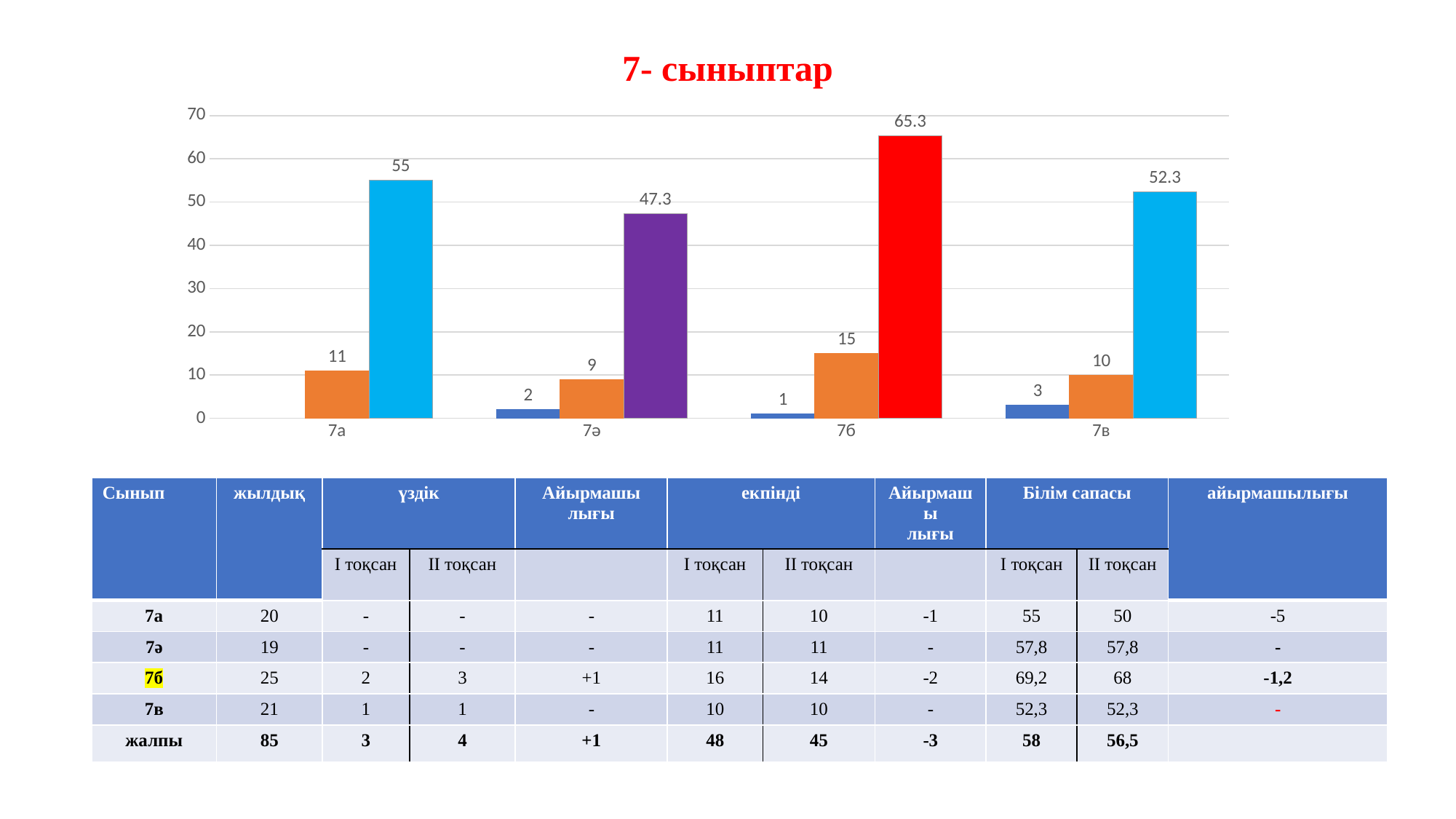
What is the value of the orange bar for 7а? 11 Which category has the highest bar on the chart? 7б Which category has the lowest labelled bar on the chart? 7б Is the tallest bar for 7в greater or less than 50? greater What is the difference between the tallest bar for 7б (65.3) and the tallest bar for 7а (55)? 10.3 What is the title of the slide above the chart? 7- сыныптар What kind of chart is shown on the slide? bar chart What is the value of the purple bar for 7ә? 47.3 What is the value of the tallest bar for 7б? 65.3 What is the value of the small dark blue bar for 7в? 3 How many categories are shown on the x axis of the chart? 4 Which is larger: the orange bar for 7б or the orange bar for 7в? 7б